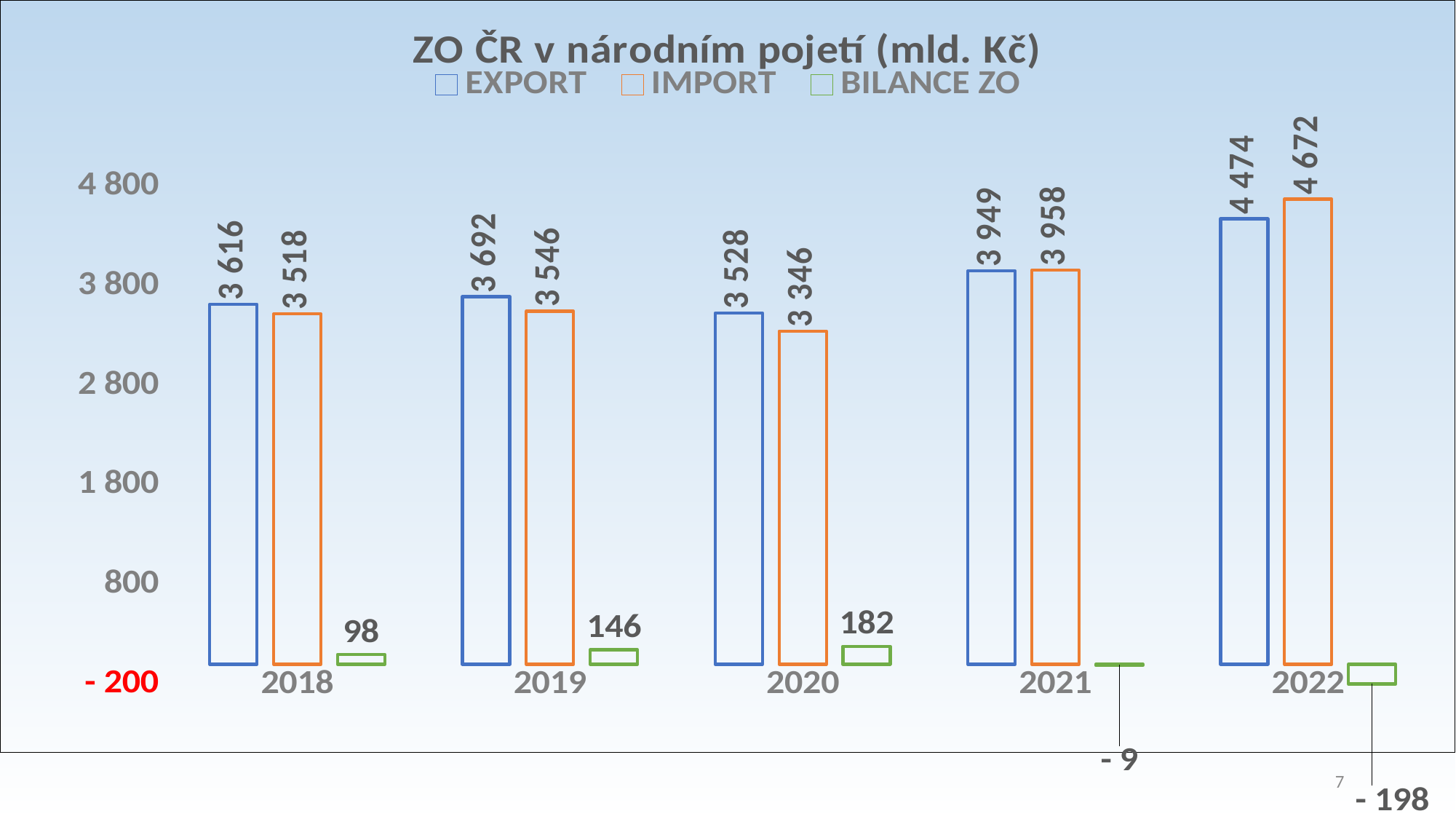
What is the difference between EXPORT and IMPORT in 2019? 146 How many years are shown on the x axis? 5 What is the EXPORT value for 2018? 3 616 Which year has the highest EXPORT value? 2022 What is the BILANCE ZO value for 2020? 182 How many series does the legend list? 3 Which year has the lowest IMPORT value? 2020 What kind of chart is shown? bar chart What is the IMPORT value for 2022? 4 672 Which is larger in 2021, EXPORT or IMPORT? IMPORT What is the title of the chart? ZO ČR v národním pojetí (mld. Kč) What is the BILANCE ZO value for 2022? - 198